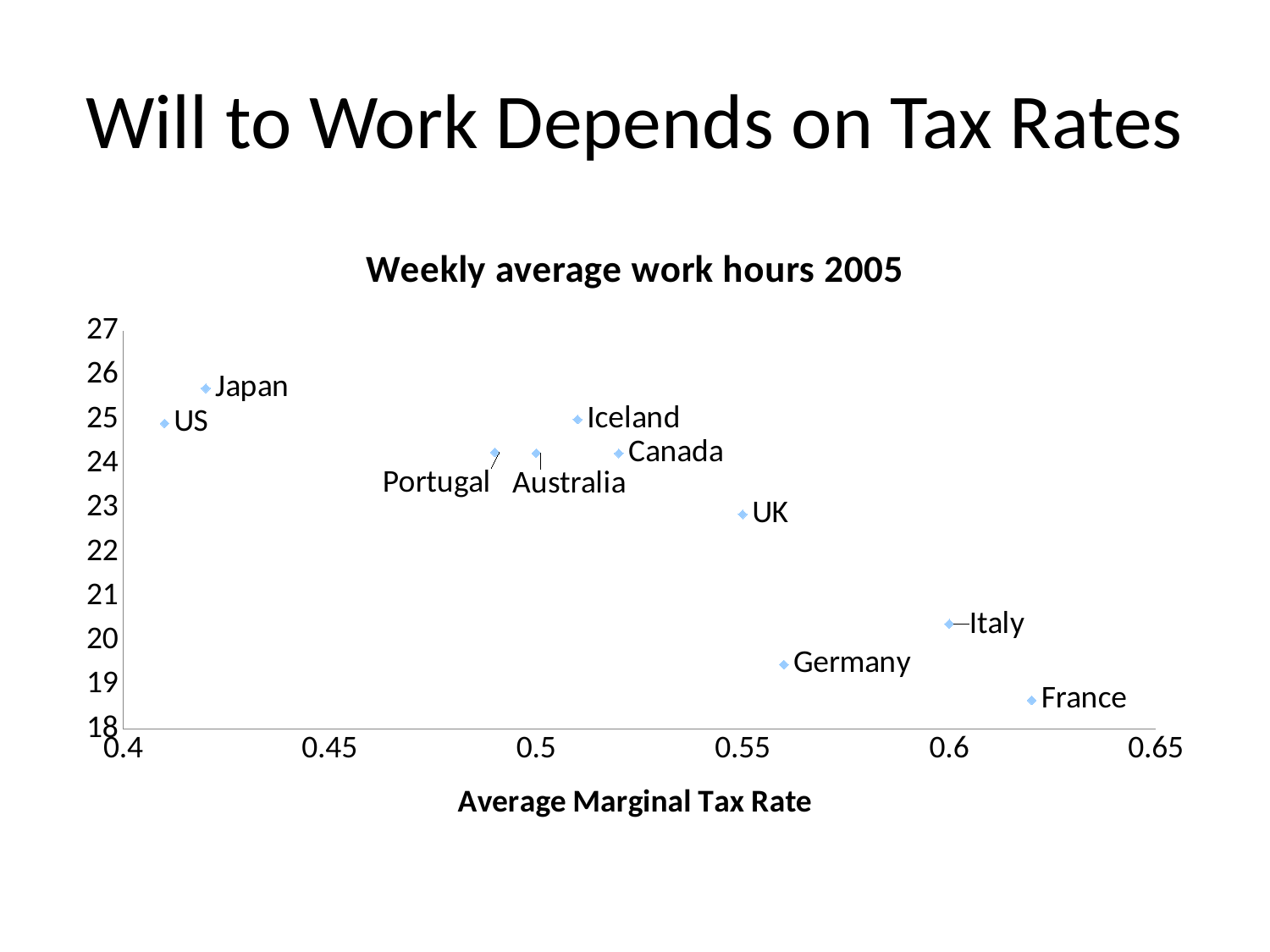
What is the label of the x axis? Average Marginal Tax Rate Is the weekly average work hours value for UK greater or less than 22? greater Is the weekly average work hours value for Iceland greater or less than 24? greater Which country has the lowest weekly average work hours? France Which country has the highest average marginal tax rate? France Is the weekly average work hours value for Germany greater or less than 20? less Which country has more weekly average work hours, UK or Germany? UK As the average marginal tax rate increases along the x axis, do weekly work hours generally rise or fall? fall Which country has the highest weekly average work hours? Japan How many countries are plotted on the chart? 10 Which country has the lowest average marginal tax rate? US What kind of chart is shown on the slide? scatter chart